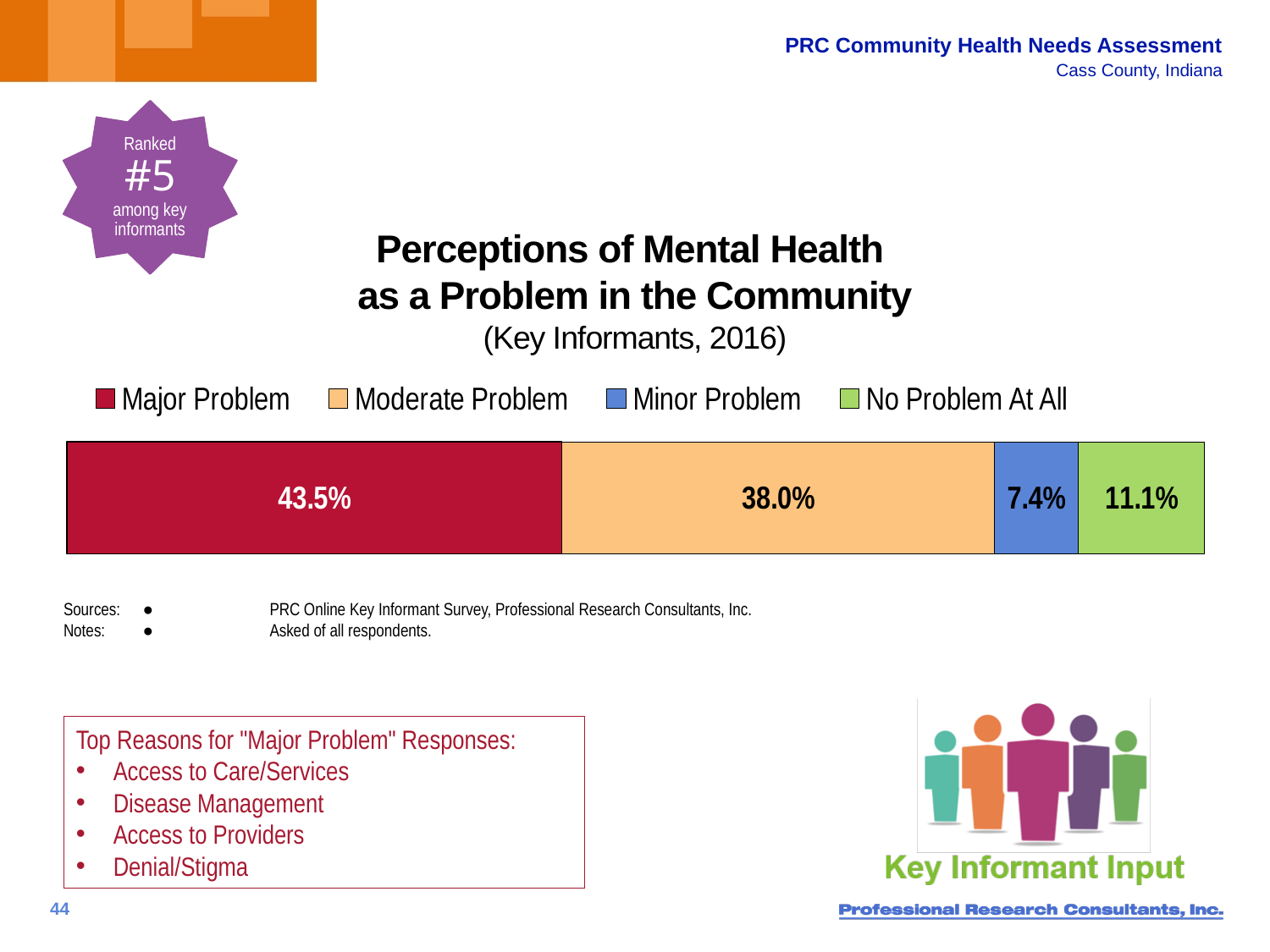
What percentage of key informants rated mental health a Moderate Problem? 38.0% Which response category has the highest percentage? Major Problem Which response category has the lowest percentage? Minor Problem What is the difference in percentage points between Major Problem and Moderate Problem responses? 5.5 What percentage of key informants rated mental health a Major Problem? 43.5% What percentage of key informants said mental health is No Problem At All? 11.1% How many entries does the legend list? 4 How many response categories are shown in the bar? 4 What percentage of key informants rated mental health a Minor Problem? 7.4% What colour represents the Moderate Problem segment? Orange What kind of chart is shown on the slide? Stacked bar chart Which is larger, the share for No Problem At All or the share for Minor Problem? No Problem At All